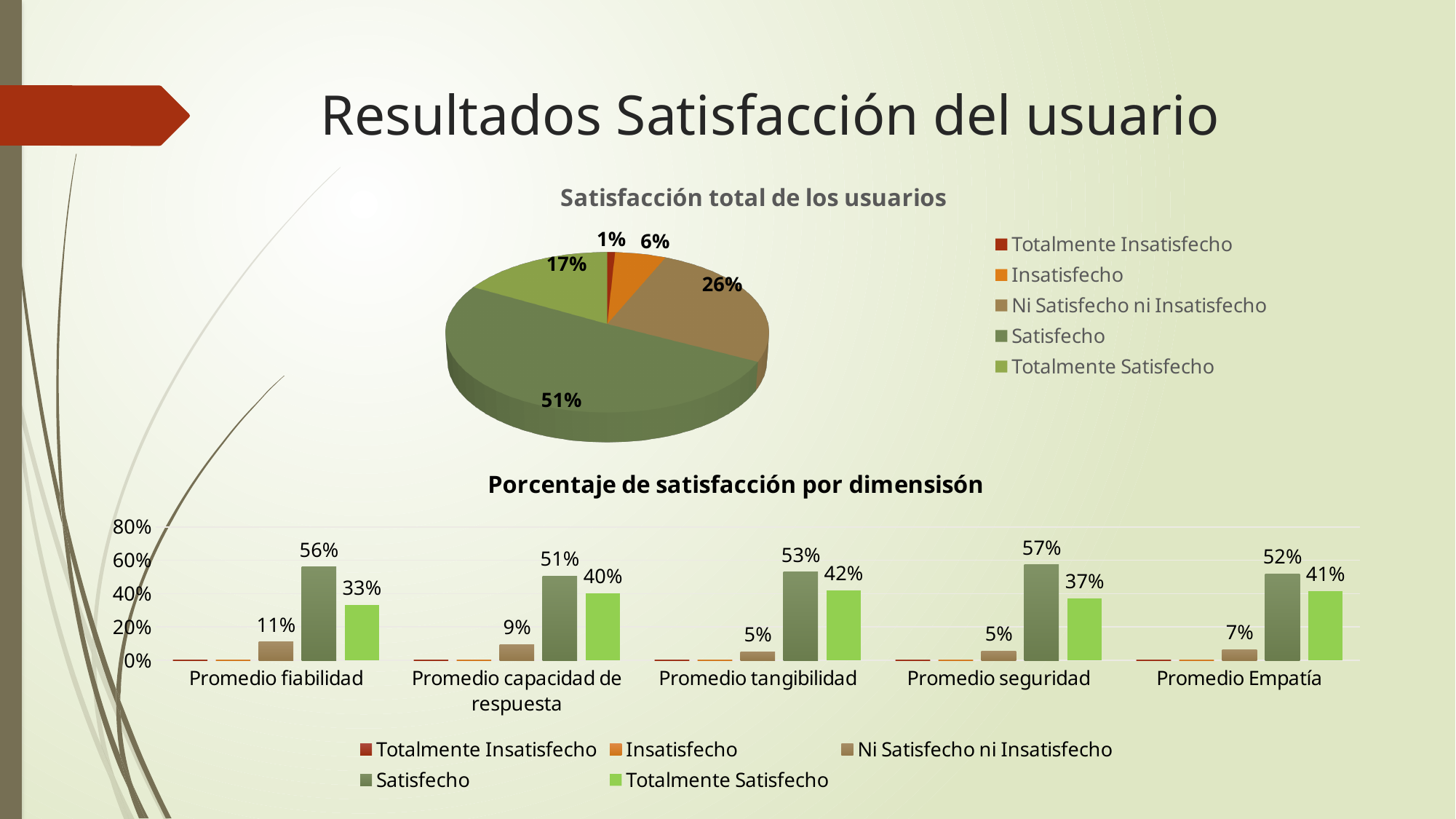
What kind of chart is 'Porcentaje de satisfacción por dimensisón'? Bar chart In the 'Porcentaje de satisfacción por dimensisón' chart, how many dimensions are shown on the x axis? 5 In the 'Satisfacción total de los usuarios' pie chart, what share is labelled for Satisfecho? 51% In the 'Porcentaje de satisfacción por dimensisón' chart, what is the difference between the Satisfecho and Totalmente Satisfecho values for Promedio capacidad de respuesta? 11% In the 'Porcentaje de satisfacción por dimensisón' chart, is the Ni Satisfecho ni Insatisfecho value higher for Promedio fiabilidad or Promedio Empatía? Promedio fiabilidad In the 'Porcentaje de satisfacción por dimensisón' chart, what is the Satisfecho value for Promedio seguridad? 57% In the 'Porcentaje de satisfacción por dimensisón' chart, what is the Totalmente Satisfecho value for Promedio fiabilidad? 33% In the 'Satisfacción total de los usuarios' pie chart, which category has the smallest slice? Totalmente Insatisfecho In the 'Porcentaje de satisfacción por dimensisón' chart, which dimension has the highest Totalmente Satisfecho value? Promedio tangibilidad In the 'Satisfacción total de los usuarios' pie chart, what share is labelled for Ni Satisfecho ni Insatisfecho? 26% In the 'Porcentaje de satisfacción por dimensisón' chart, how many series does the legend list? 5 In the 'Satisfacción total de los usuarios' pie chart, how many categories does the legend list? 5